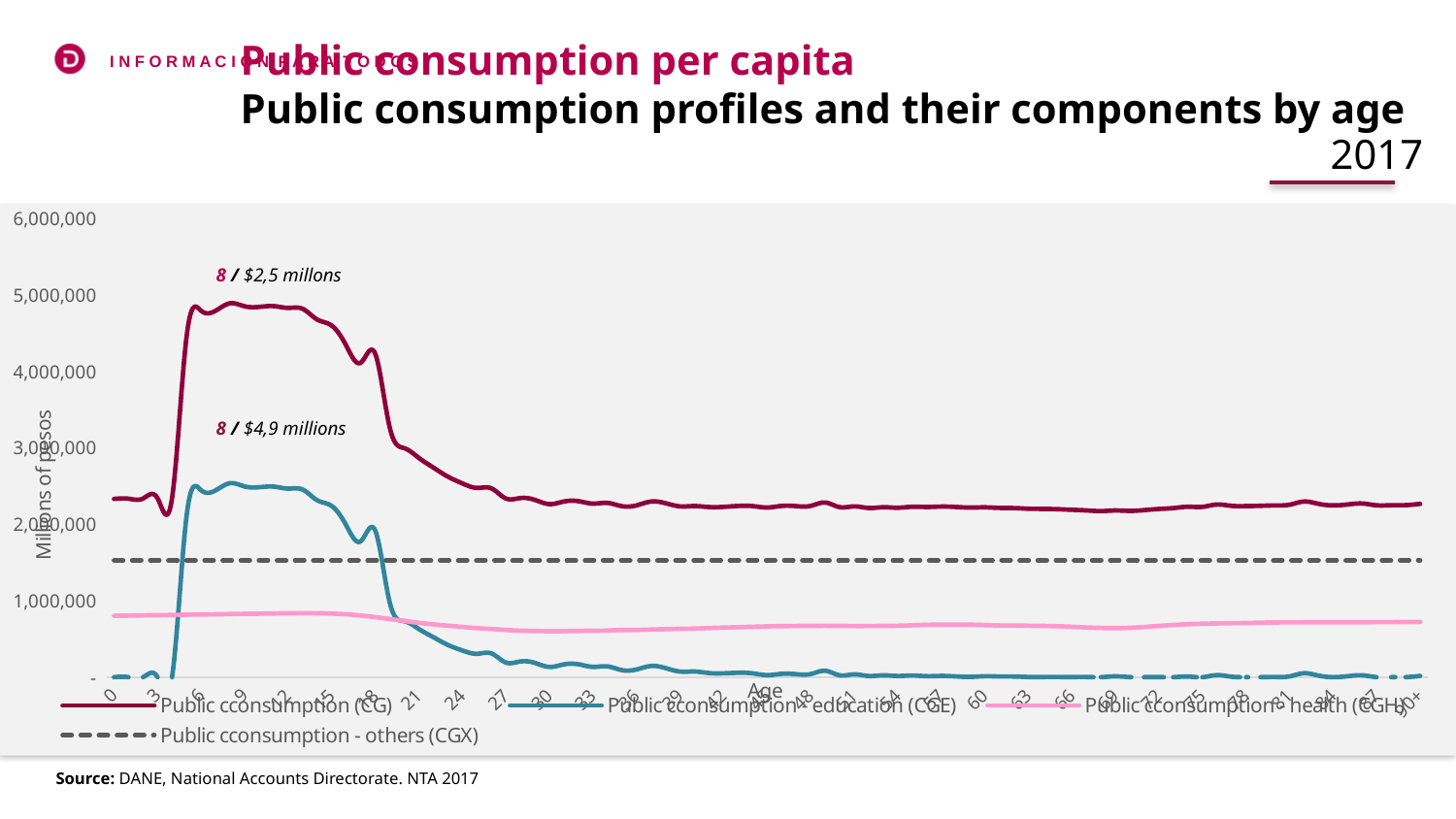
What kind of chart is shown on the slide? Line chart Is the value of Public consumption (CG) at age 0 greater or less than 2,000,000? greater Is the value of Public consumption - health (CGH) at age 0 greater or less than 1,000,000? less At age 60, which is larger: Public consumption - health (CGH) or Public consumption - education (CGE)? Public consumption - health (CGH) Is the peak value of Public consumption - education (CGE) greater or less than 3,000,000? less Which series is drawn as a dashed line? Public consumption - others (CGX) What is the label of the vertical axis? Millions of pesos How many series does the legend list? 4 Which series has the highest values across all ages? Public consumption (CG) Does Public consumption - education (CGE) rise or fall between age 20 and age 40? Fall